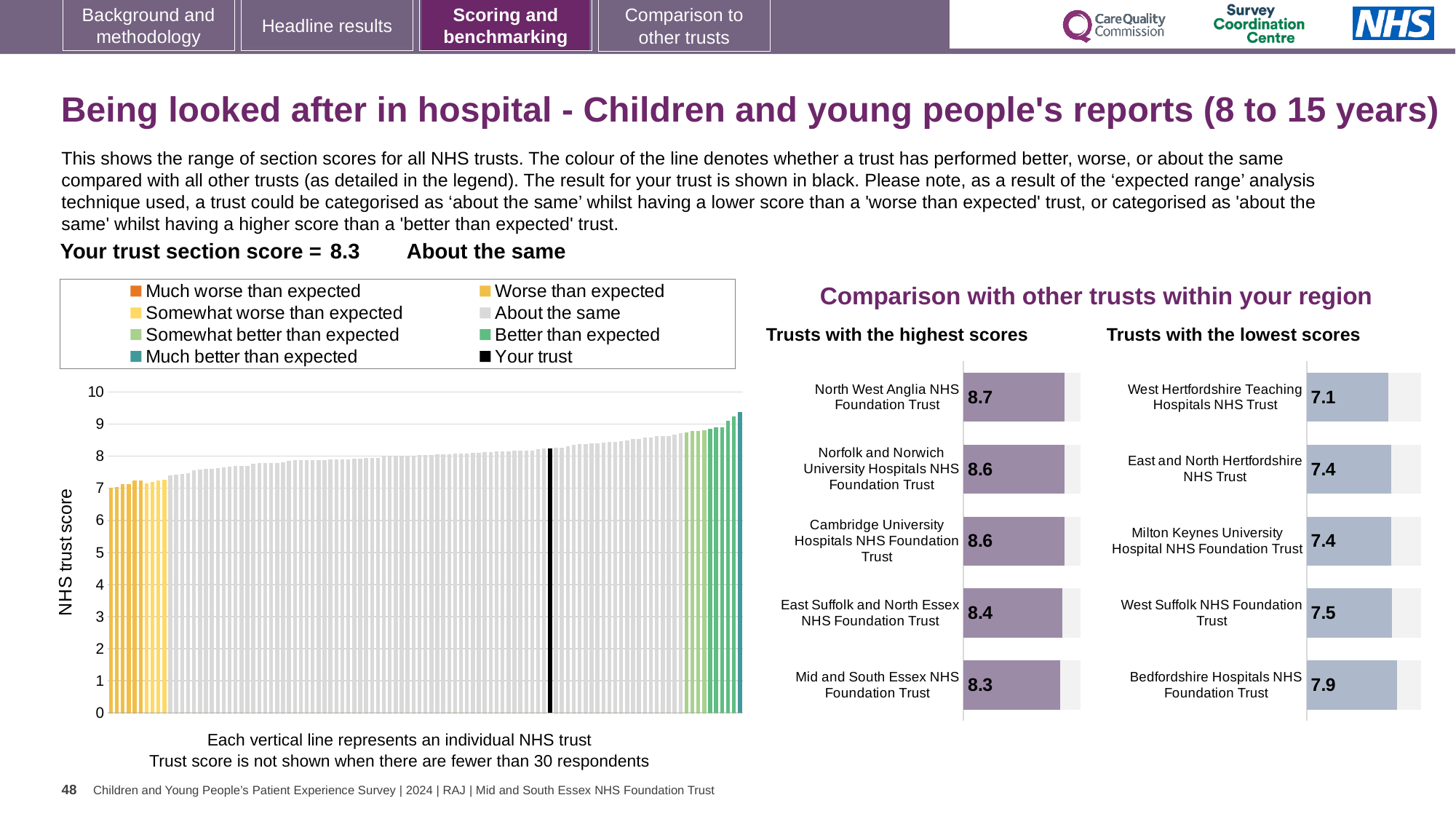
In the 'Trusts with the lowest scores' chart, what is the difference between the scores of Bedfordshire Hospitals NHS Foundation Trust and West Hertfordshire Teaching Hospitals NHS Trust? 0.8 In the 'Trusts with the lowest scores' chart, what is the score for Bedfordshire Hospitals NHS Foundation Trust? 7.9 In the 'Trusts with the highest scores' chart, what is the score for North West Anglia NHS Foundation Trust? 8.7 In the 'Trusts with the lowest scores' chart, which trust has the lowest score? West Hertfordshire Teaching Hospitals NHS Trust How many trusts are shown in the 'Trusts with the lowest scores' chart? 5 In the 'Trusts with the highest scores' chart, what is the difference between the scores of North West Anglia NHS Foundation Trust and Mid and South Essex NHS Foundation Trust? 0.4 In the 'Trusts with the highest scores' chart, which has the larger score: Cambridge University Hospitals NHS Foundation Trust or East Suffolk and North Essex NHS Foundation Trust? Cambridge University Hospitals NHS Foundation Trust In the main 'NHS trust score' chart on the left, do the trust scores rise or fall from left to right? Rise How many entries does the legend of the main 'NHS trust score' chart on the left list? 8 What kind of chart is the main 'NHS trust score' chart on the left of the slide? Bar chart What is the y-axis title of the main chart on the left of the slide? NHS trust score In the 'Trusts with the highest scores' chart, which trust has the highest score? North West Anglia NHS Foundation Trust